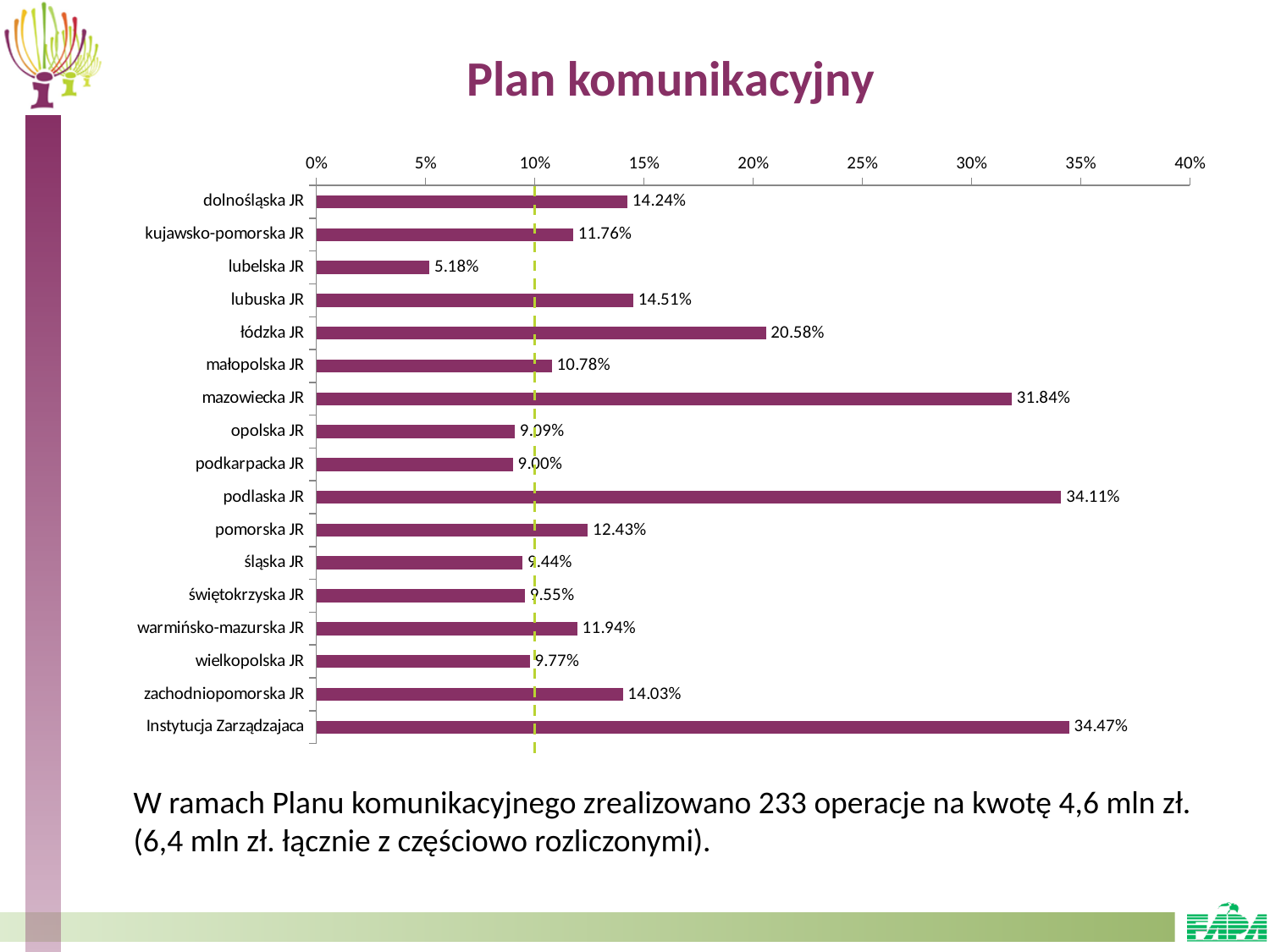
How many categories are shown in the chart? 17 At what value on the axis is the vertical dashed line drawn? 10% Which category has the lowest value? lubelska JR What is the value for lubelska JR? 5.18% Which is larger, the value for lubuska JR or the value for dolnośląska JR? lubuska JR What is the value for mazowiecka JR? 31.84% What kind of chart is shown on the slide? bar chart Is the value for podlaska JR greater or less than 30%? greater What is the value for świętokrzyska JR? 9.55% Which category has the highest value? Instytucja Zarządzajaca What is the difference between the values for mazowiecka JR and łódzka JR? 11.26 percentage points What is the value for Instytucja Zarządzajaca? 34.47%